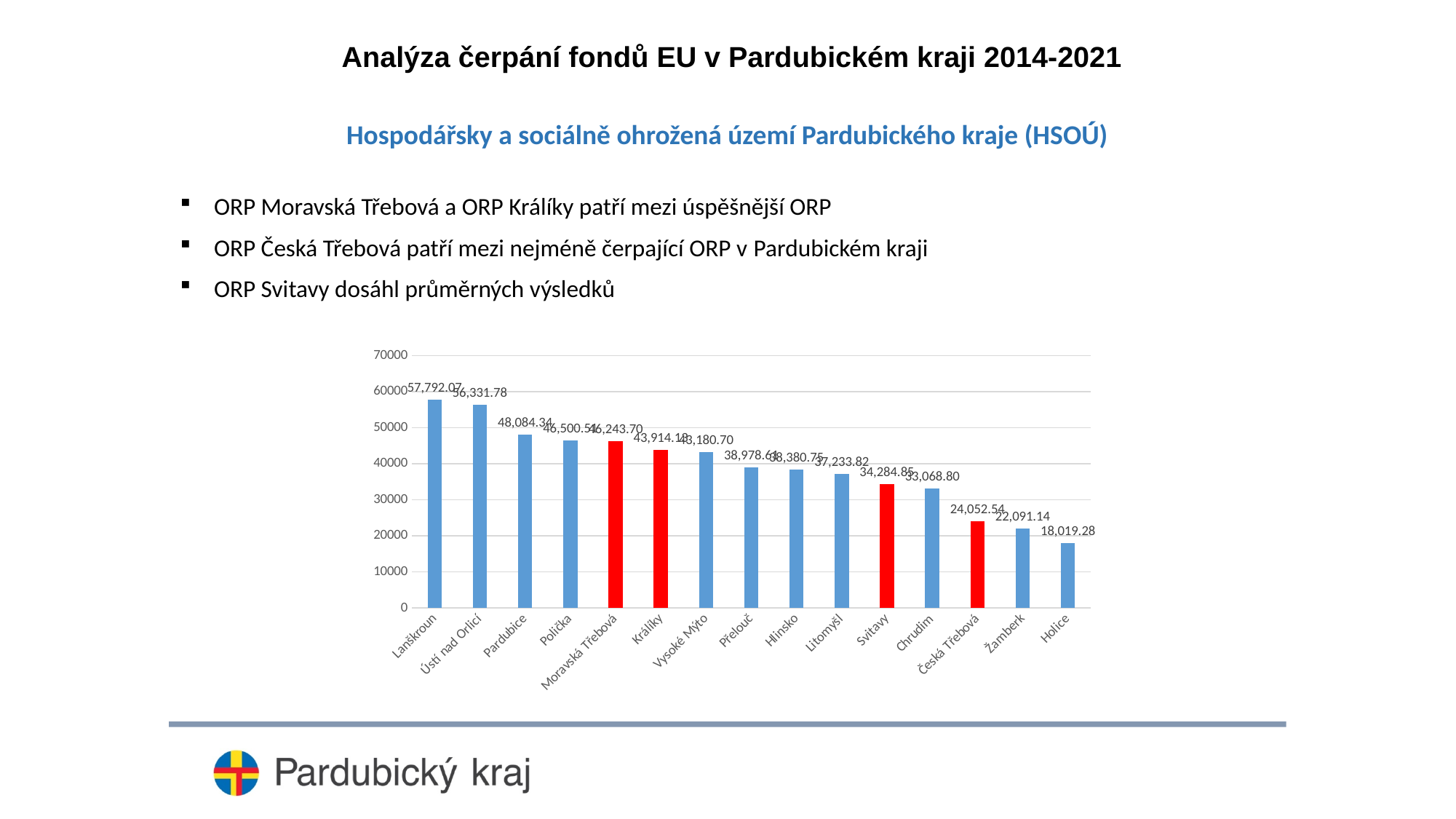
Which is larger, the value for Pardubice or the value for Chrudim? Pardubice What is the value for Svitavy? 34,284.85 Is the value for Žamberk greater or less than 30000? less How many ORP categories are plotted on the chart? 15 What is the difference between the values for Lanškroun and Holice? 39,772.79 What is the value for Česká Třebová? 24,052.54 Which ORP has the highest value on the chart? Lanškroun What is the value for Holice? 18,019.28 What type of chart is shown on the slide? bar chart What is the value for Lanškroun? 57,792.07 Which ORP bars are coloured red on the chart? Moravská Třebová, Králíky, Svitavy, Česká Třebová Which ORP has the lowest value on the chart? Holice